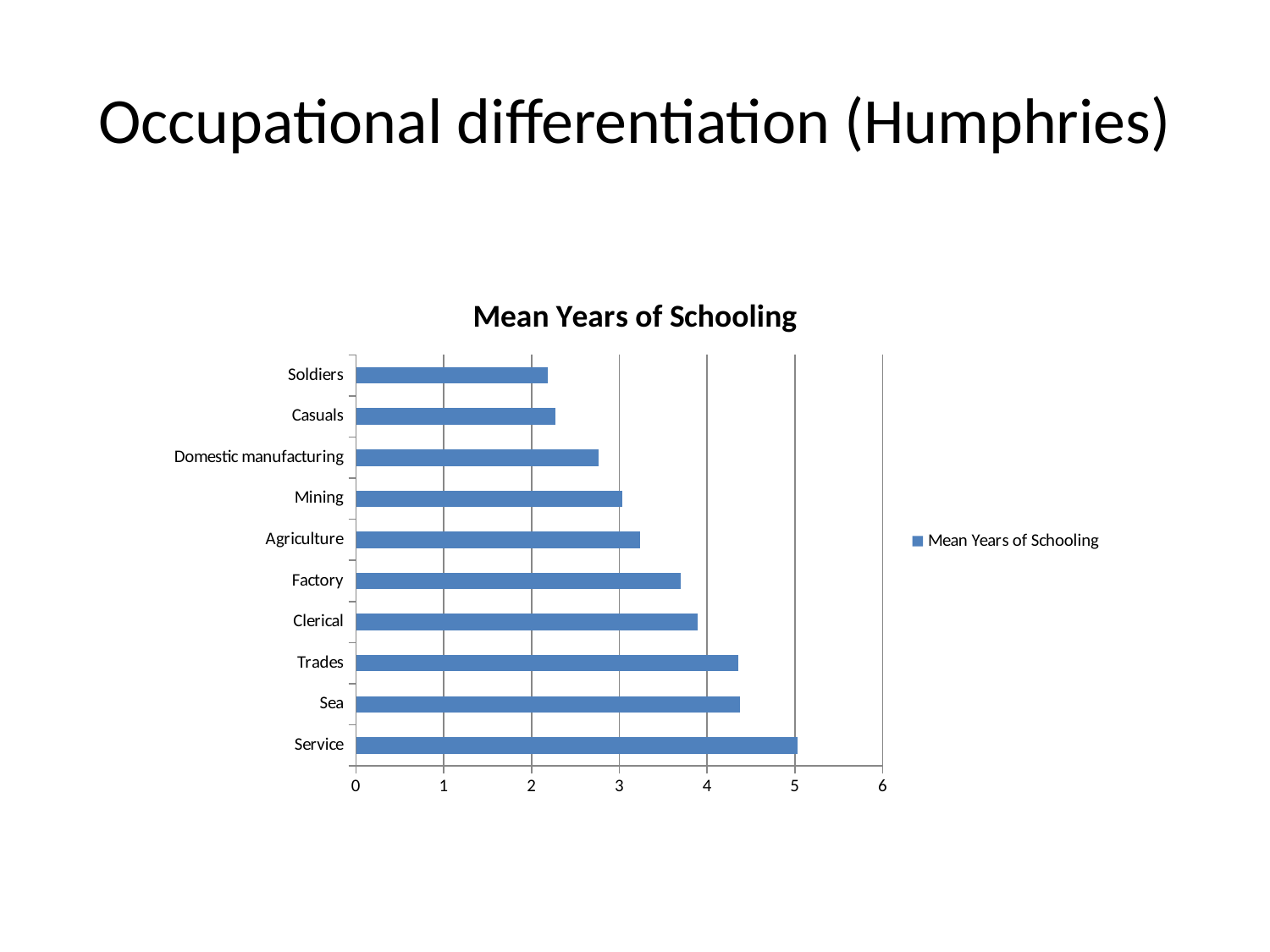
Which occupation has the highest mean years of schooling? Service Is the value for Soldiers greater or less than 3? less What is the title of the chart? Mean Years of Schooling Is the value for Trades greater or less than 4? greater Is the value for Domestic manufacturing greater or less than 3? less How many series does the legend list? 1 Which has a higher mean years of schooling, Casuals or Clerical? Clerical Which has a higher mean years of schooling, Factory or Mining? Factory How many occupational categories are plotted in the chart? 10 What kind of chart is shown on the slide? Bar chart